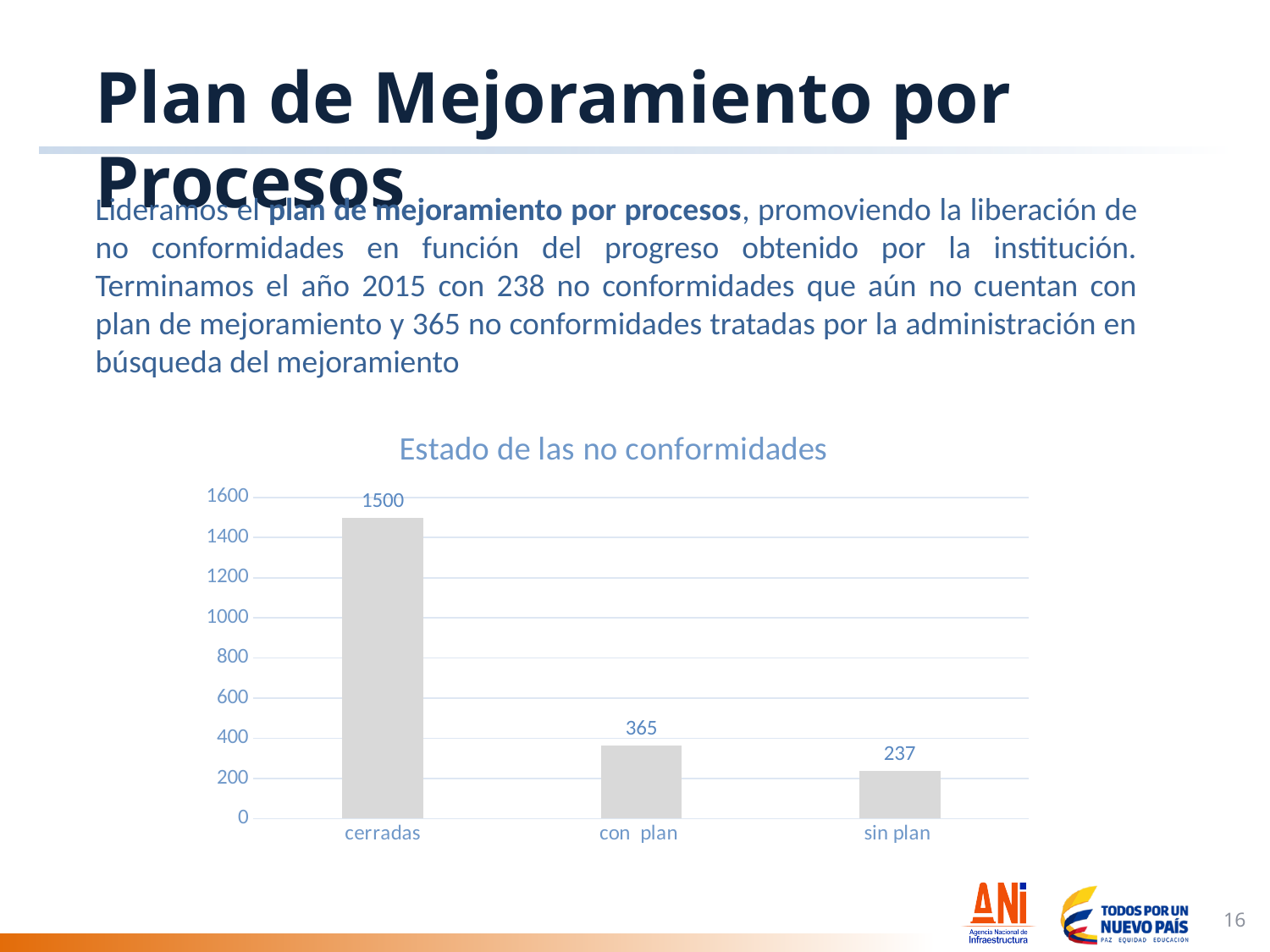
What kind of chart is shown on the slide? bar chart Which category has the highest value? cerradas What is the value for 'con plan'? 365 Which is larger, the value for 'con plan' or the value for 'sin plan'? con plan What is the difference between the values for 'cerradas' and 'con plan'? 1135 What is the value for 'cerradas'? 1500 What is the value for 'sin plan'? 237 How many categories are shown on the x axis? 3 Is the value for 'sin plan' greater or less than 400? less Which category has the lowest value? sin plan What is the difference between the values for 'con plan' and 'sin plan'? 128 What is the title of the chart? Estado de las no conformidades